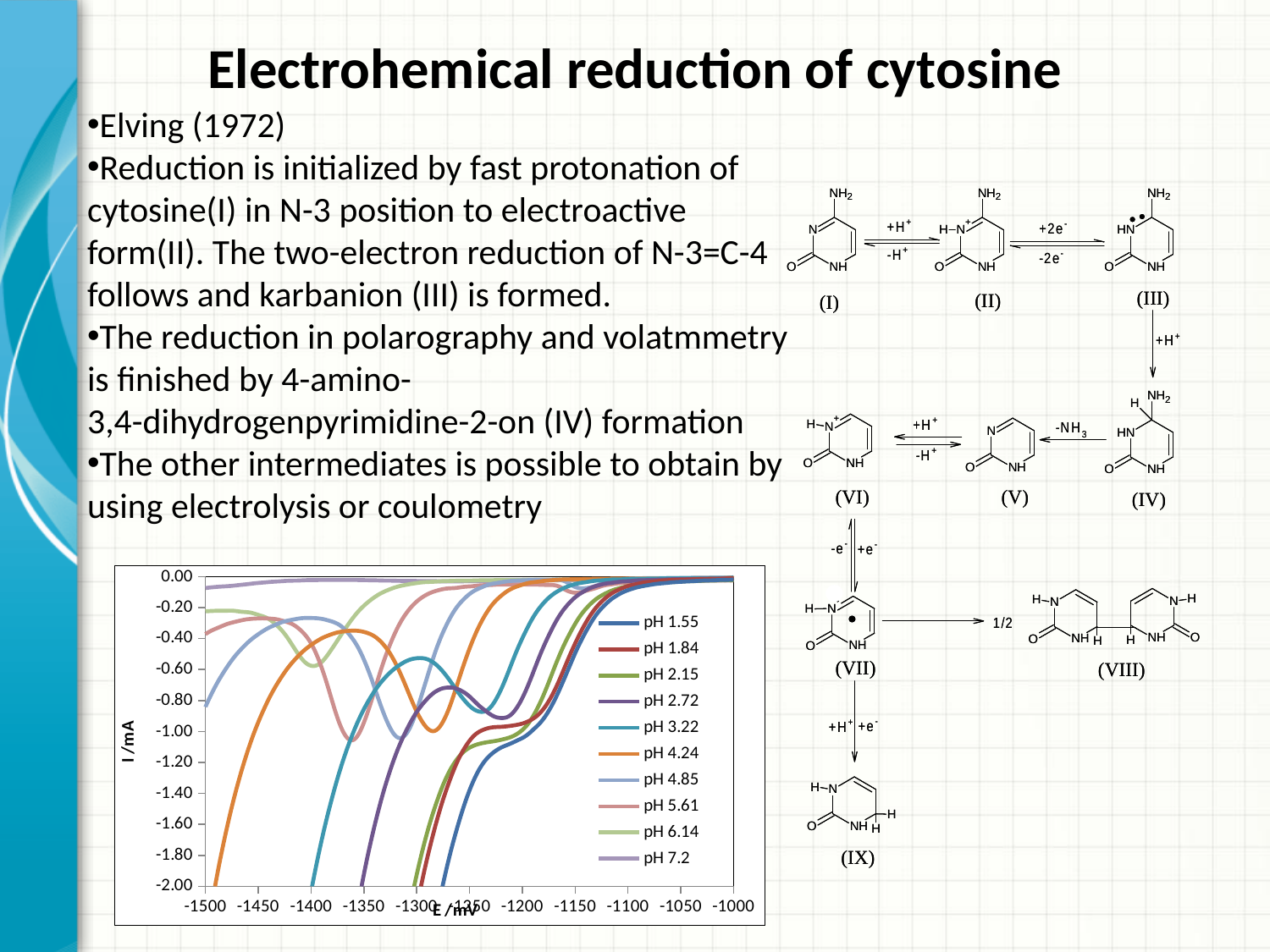
Is the value for pH 7.2 at -1500 mV greater or less than -0.20? greater Is the value for pH 6.14 at -1400 mV greater or less than -0.40? less Does the pH 1.55 curve rise or fall as E goes from -1250 mV to -1000 mV? rise Is the value for pH 4.24 at -1500 mV greater or less than -1.00? less What is the label of the x axis of the chart? E / mV How many series does the chart legend list? 10 What kind of chart is shown on the slide? line chart What is the label of the y axis of the chart? I /mA At -1500 mV, which is larger, the value for pH 7.2 or the value for pH 4.24? pH 7.2